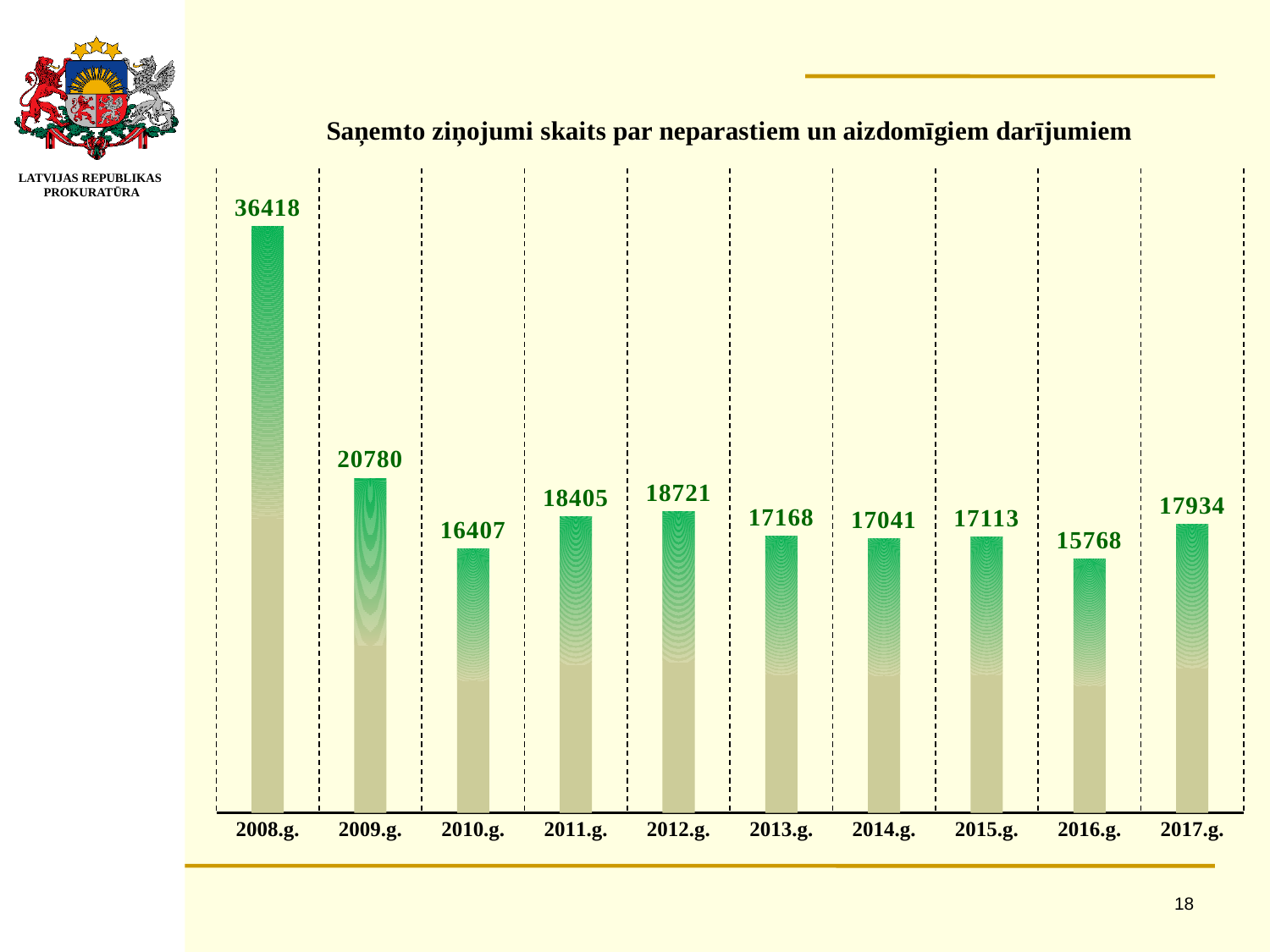
Do the values rise or fall from 2008.g. to 2010.g.? fall Which year has the lowest value? 2016.g. Which year has the highest value? 2008.g. What is the value for 2008.g.? 36418 What is the difference between the values for 2008.g. and 2009.g.? 15638 What is the title of the chart? Saņemto ziņojumi skaits par neparastiem un aizdomīgiem darījumiem How many years are shown on the x axis? 10 What kind of chart is this? bar chart What is the value for 2012.g.? 18721 What is the difference between the values for 2017.g. and 2016.g.? 2166 Which is larger, the value for 2011.g. or the value for 2012.g.? 2012.g. What is the value for 2016.g.? 15768